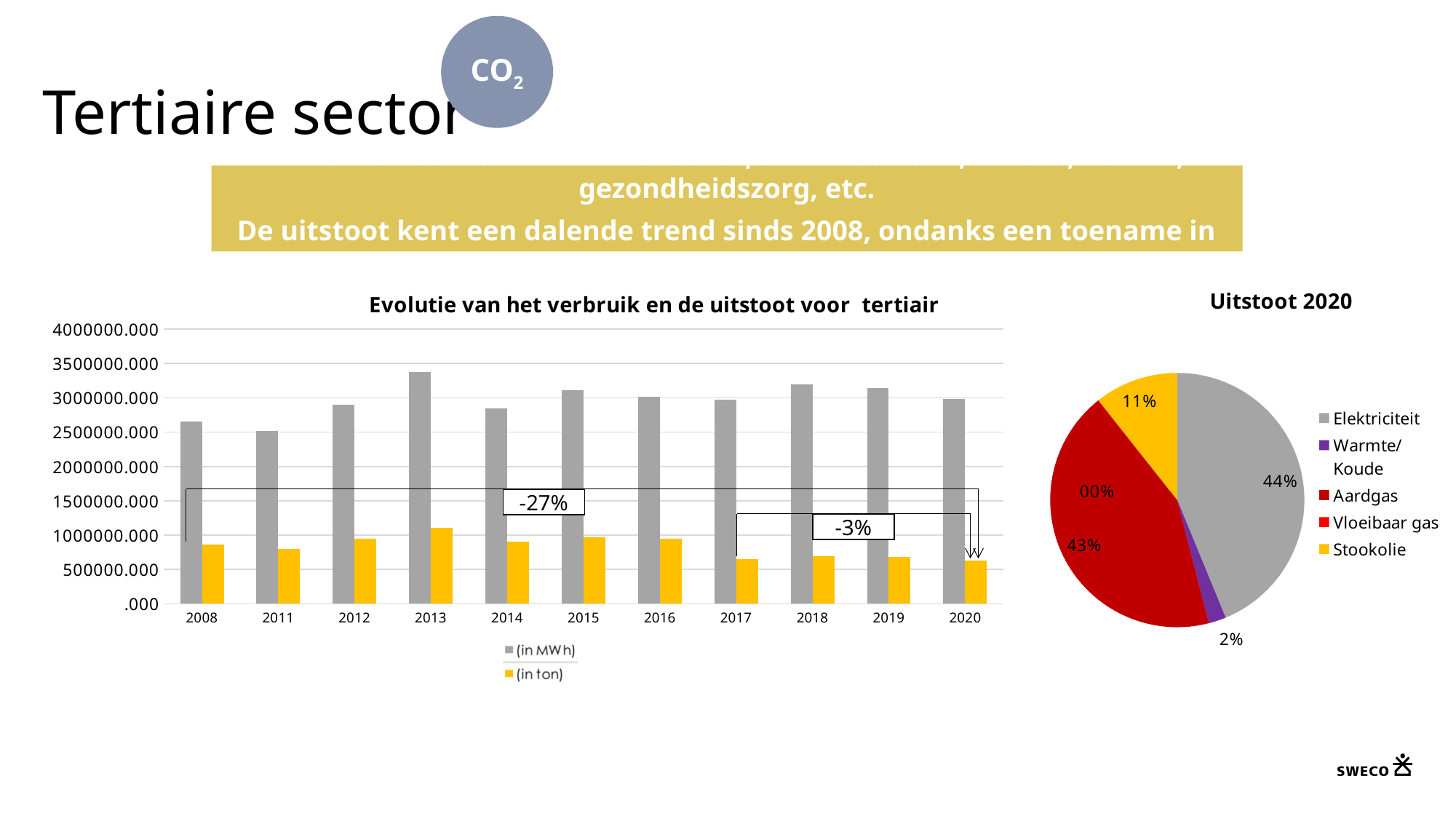
In the chart 'Evolutie van het verbruik en de uitstoot voor tertiair', which year has the larger '(in ton)' value, 2013 or 2017? 2013 In the chart 'Evolutie van het verbruik en de uitstoot voor tertiair', which year has the lowest value for '(in MWh)'? 2011 In the pie chart 'Uitstoot 2020', what is the difference between the shares of Elektriciteit and Stookolie? 33% In the chart 'Evolutie van het verbruik en de uitstoot voor tertiair', how many years are shown on the x axis? 11 In the pie chart 'Uitstoot 2020', what share does Aardgas have? 43% In the pie chart 'Uitstoot 2020', what share does Elektriciteit have? 44% In the chart 'Evolutie van het verbruik en de uitstoot voor tertiair', is the '(in ton)' value for 2008 greater or less than 1000000.000? less What kind of chart is 'Evolutie van het verbruik en de uitstoot voor tertiair'? bar chart In the pie chart 'Uitstoot 2020', how many categories does the legend list? 5 In the chart 'Evolutie van het verbruik en de uitstoot voor tertiair', how many series does the legend list? 2 In the chart 'Evolutie van het verbruik en de uitstoot voor tertiair', is the '(in MWh)' value for 2013 greater or less than 3000000.000? greater In the chart 'Evolutie van het verbruik en de uitstoot voor tertiair', which year has the highest value for '(in MWh)'? 2013